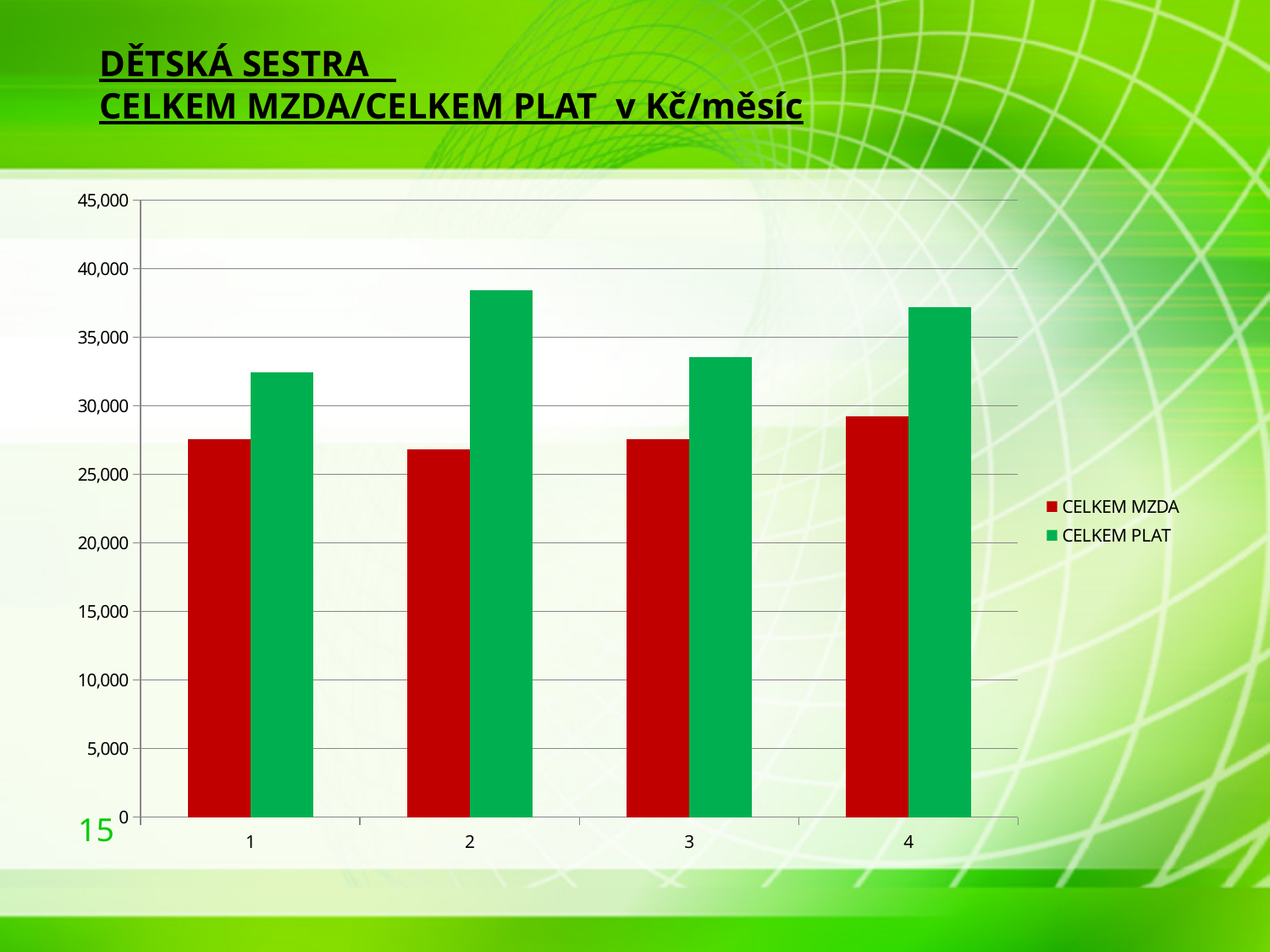
Is the CELKEM MZDA value for category 1 greater or less than 30,000? less Which category has the highest CELKEM PLAT value? 2 Is the CELKEM PLAT value for category 2 greater or less than 35,000? greater What kind of chart is shown on the slide? bar chart How many categories are shown on the x axis? 4 Which category has the highest CELKEM MZDA value? 4 Which category has the lowest CELKEM PLAT value? 1 Which colour represents the CELKEM MZDA series? red Is the CELKEM PLAT value for category 1 greater or less than 30,000? greater In category 2, which is larger, CELKEM MZDA or CELKEM PLAT? CELKEM PLAT What is the title of the slide above the chart? DĚTSKÁ SESTRA CELKEM MZDA/CELKEM PLAT v Kč/měsíc How many series does the legend list? 2